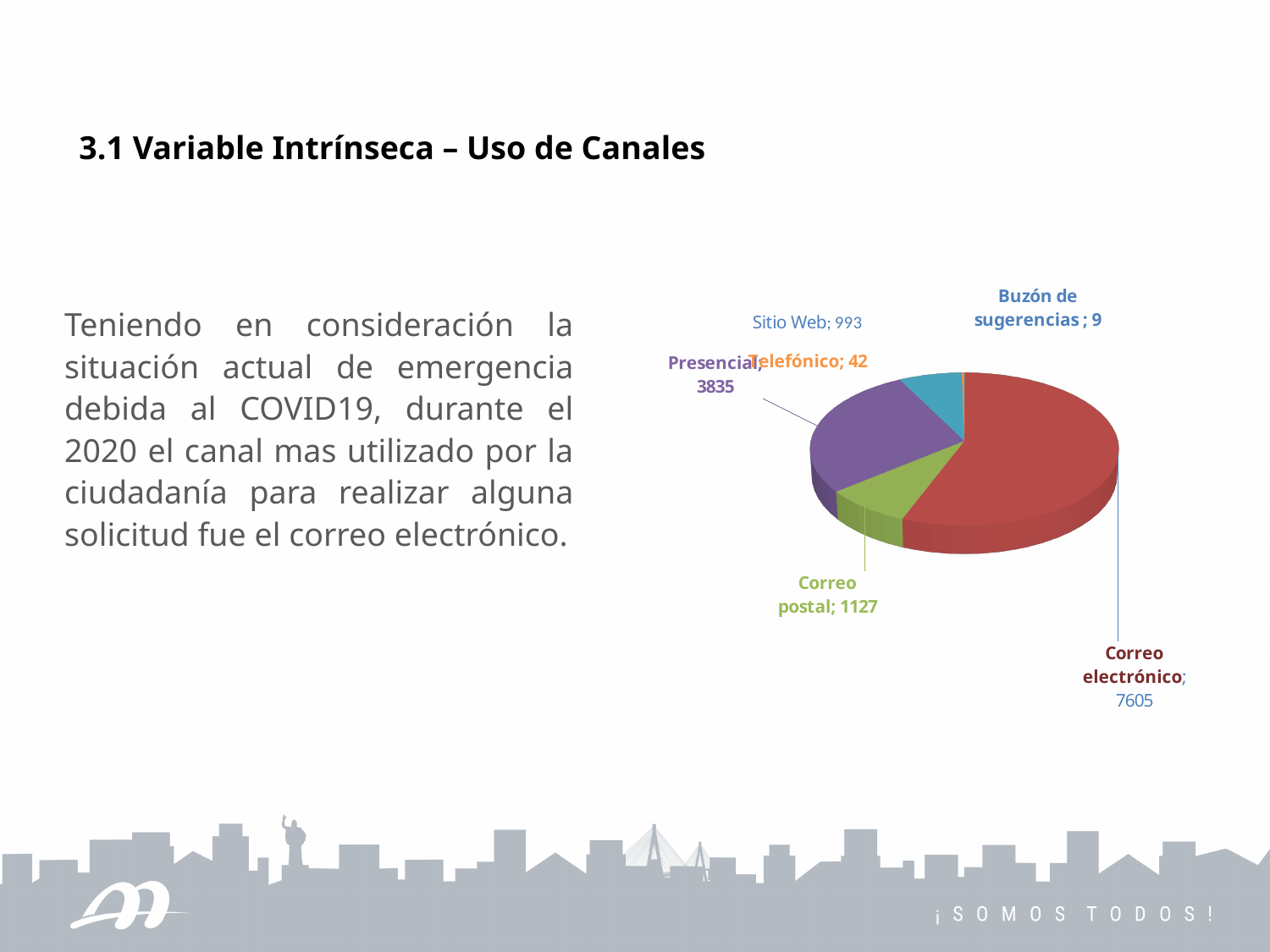
What is the value for Buzón de sugerencias in the pie chart? 9 What is the value for Sitio Web in the pie chart? 993 Which category has the smallest slice in the pie chart? Buzón de sugerencias What kind of chart is shown on the slide? Pie chart What is the difference between the values for Presencial and Correo postal? 2708 Which is larger, the value for Correo postal or the value for Sitio Web? Correo postal What is the value for Presencial in the pie chart? 3835 What is the difference between the values for Correo electrónico and Presencial? 3770 How many categories (slices) does the pie chart show? 6 What is the value for Correo electrónico in the pie chart? 7605 Which category has the largest slice in the pie chart? Correo electrónico What is the value for Telefónico in the pie chart? 42